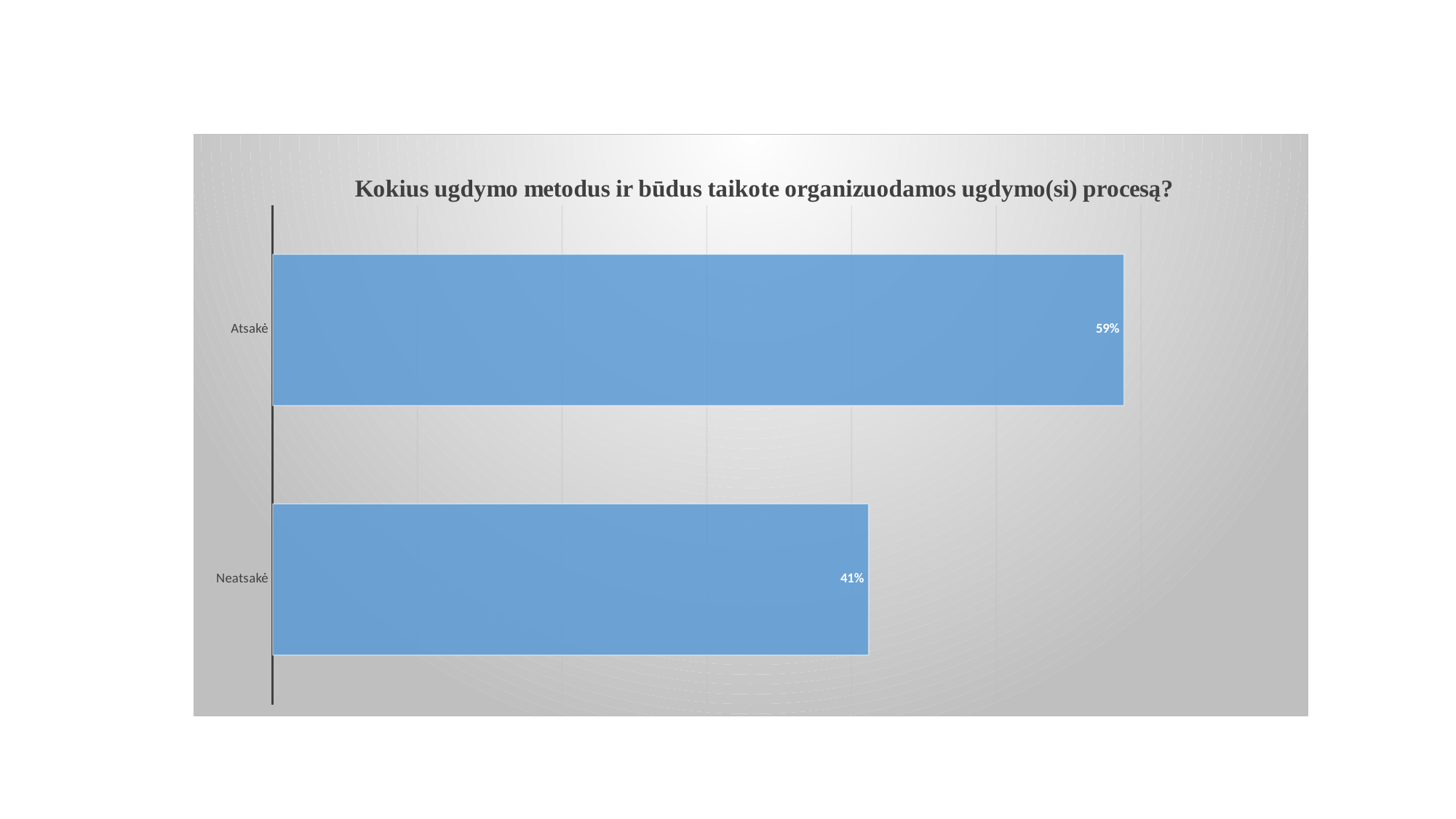
What is the title of the chart? Kokius ugdymo metodus ir būdus taikote organizuodamos ugdymo(si) procesą? What kind of chart is shown on the slide? Bar chart What is the difference between the values for Atsakė and Neatsakė? 18% Which category has the lowest value? Neatsakė Which is larger, the value for Atsakė or the value for Neatsakė? Atsakė What is the value for Atsakė? 59% Which category has the highest value? Atsakė What colour are the bars in the chart? Blue How many categories are shown in the chart? 2 What is the total of the values for Atsakė and Neatsakė? 100% What is the value for Neatsakė? 41%